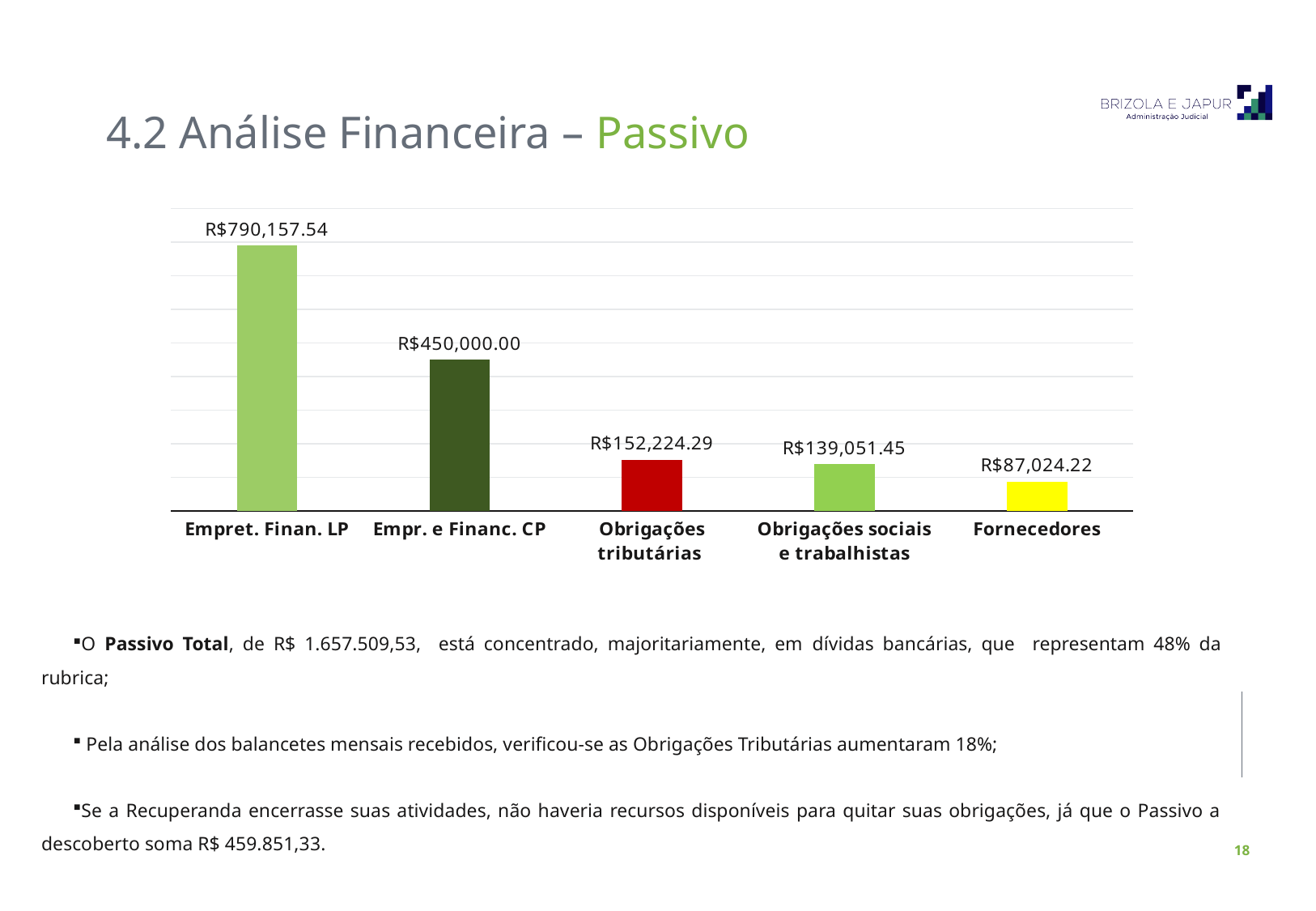
What is the value for Obrigações tributárias? R$152,224.29 What is the difference between Obrigações sociais e trabalhistas and Fornecedores? R$52,027.23 Which category has the highest value? Empret. Finan. LP How many categories are shown in the chart? 5 What kind of chart is shown on the slide? Bar chart What is the difference between Empret. Finan. LP and Empr. e Financ. CP? R$340,157.54 Do the values rise or fall from left to right across the categories? Fall What is the value for Empr. e Financ. CP? R$450,000.00 What is the value for Fornecedores? R$87,024.22 What is the value for Empret. Finan. LP? R$790,157.54 Which category has the lowest value? Fornecedores Which is larger, Obrigações tributárias or Obrigações sociais e trabalhistas? Obrigações tributárias